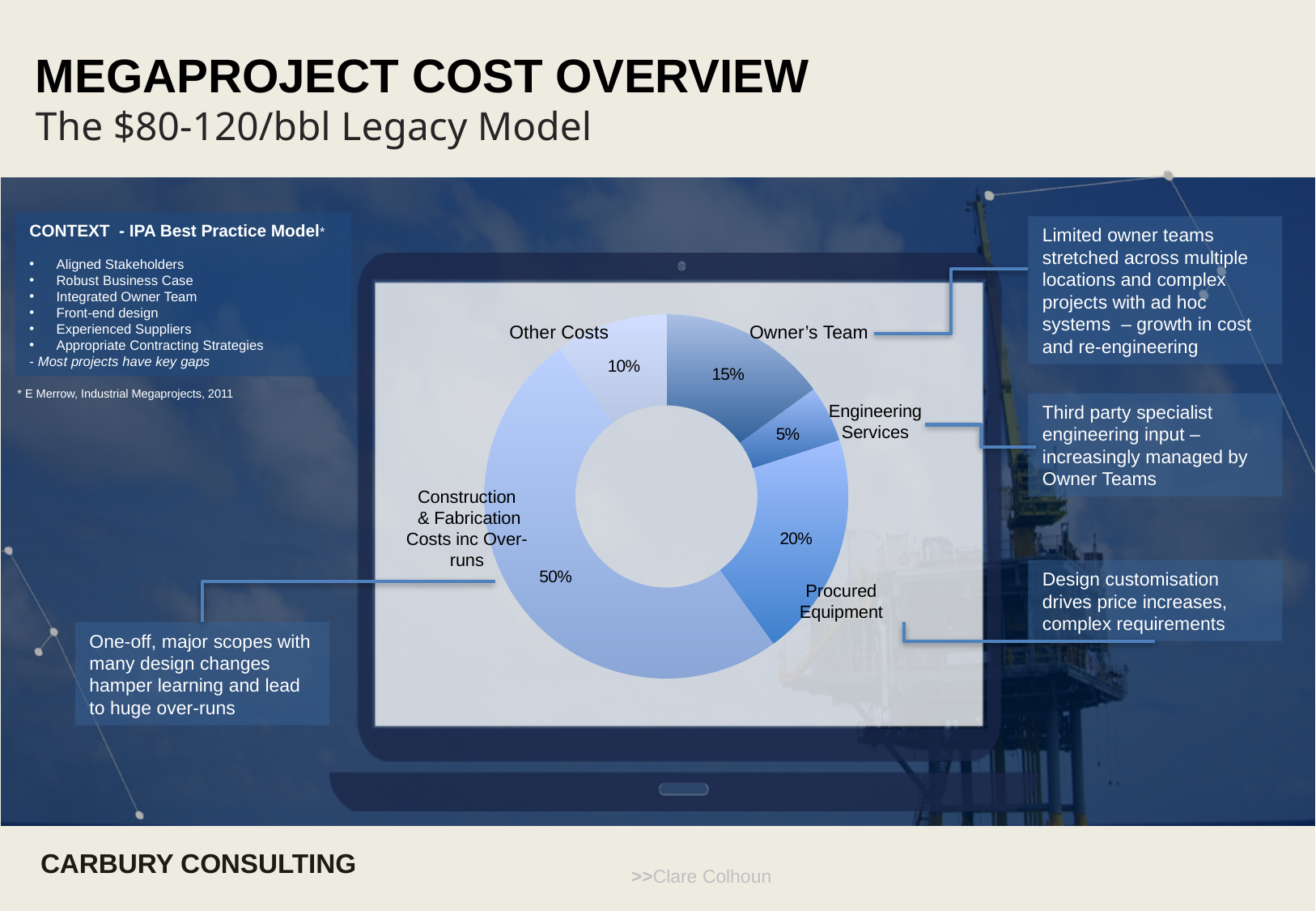
What percentage is shown for Construction & Fabrication Costs inc Over-runs? 50% Which is larger, the share for Other Costs or the share for Procured Equipment? Procured Equipment What is the difference in percentage points between Procured Equipment and Owner's Team? 5 What kind of chart is shown on the slide? Doughnut chart How many categories are shown in the chart? 5 Which category has the largest share of the chart? Construction & Fabrication Costs inc Over-runs What percentage is shown for Procured Equipment? 20% What is the combined share of Owner's Team and Engineering Services? 20% What percentage is shown for Other Costs? 10% What percentage is shown for Engineering Services? 5% What percentage is shown for Owner's Team? 15% Which category has the smallest share of the chart? Engineering Services